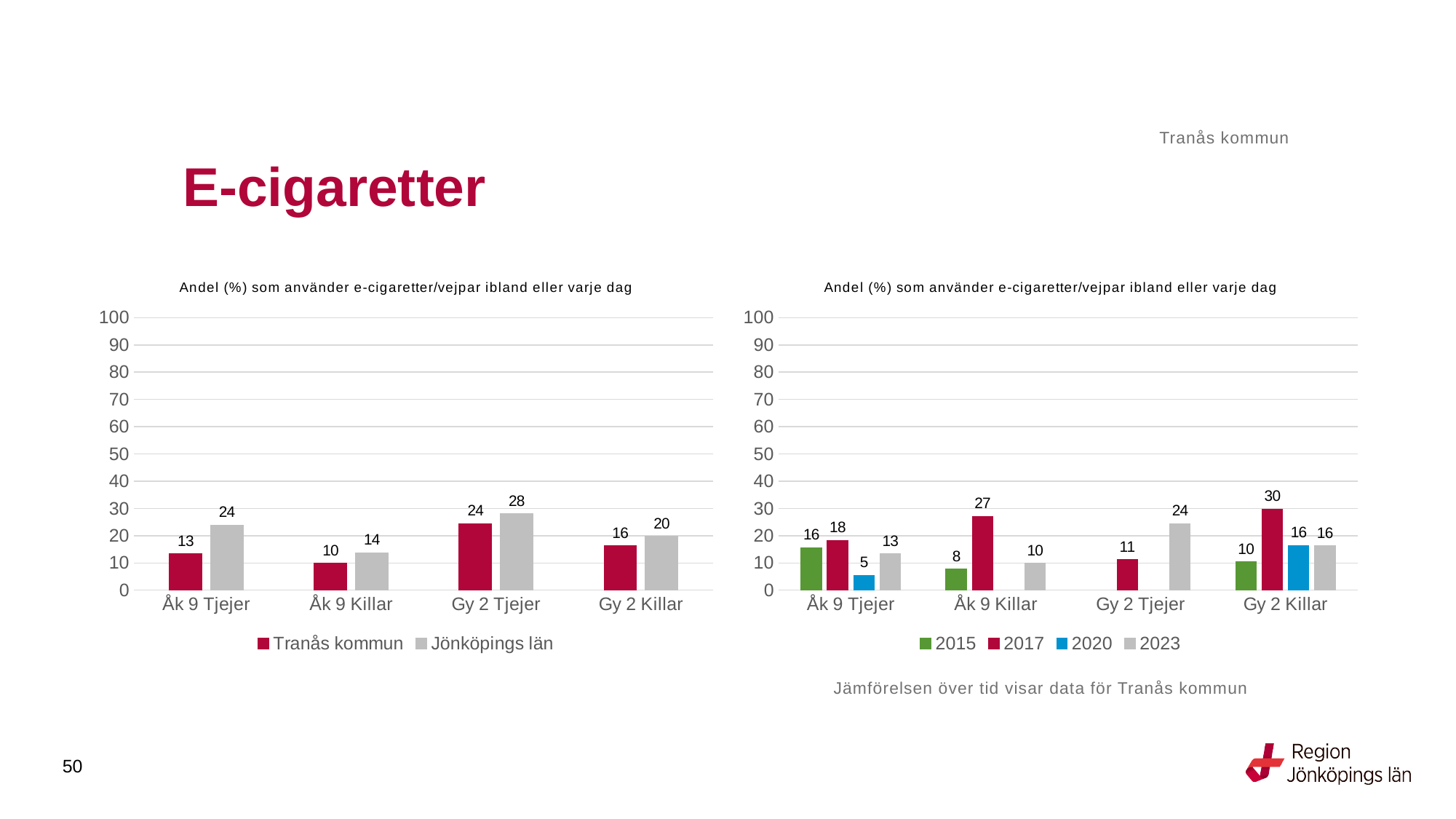
In the right chart, is the value for 2017 for Åk 9 Killar larger or smaller than the value for 2023 for Åk 9 Killar? larger In the left chart, what is the value for Tranås kommun for Gy 2 Tjejer? 24 In the right chart, what is the value for 2017 for Gy 2 Killar? 30 In the right chart, what is the difference between the 2017 and 2023 values for Gy 2 Tjejer? 13 What kind of chart is the left chart? bar chart In the right chart, what is the value for 2020 for Åk 9 Tjejer? 5 In the left chart, what is the difference between Jönköpings län and Tranås kommun for Åk 9 Tjejer? 11 In the right chart, which category has the lowest value for 2015? Åk 9 Killar In the left chart, how many series does the legend list? 2 In the right chart, how many series does the legend list? 4 In the left chart, what is the value for Jönköpings län for Åk 9 Killar? 14 In the left chart, which category has the highest value for Jönköpings län? Gy 2 Tjejer